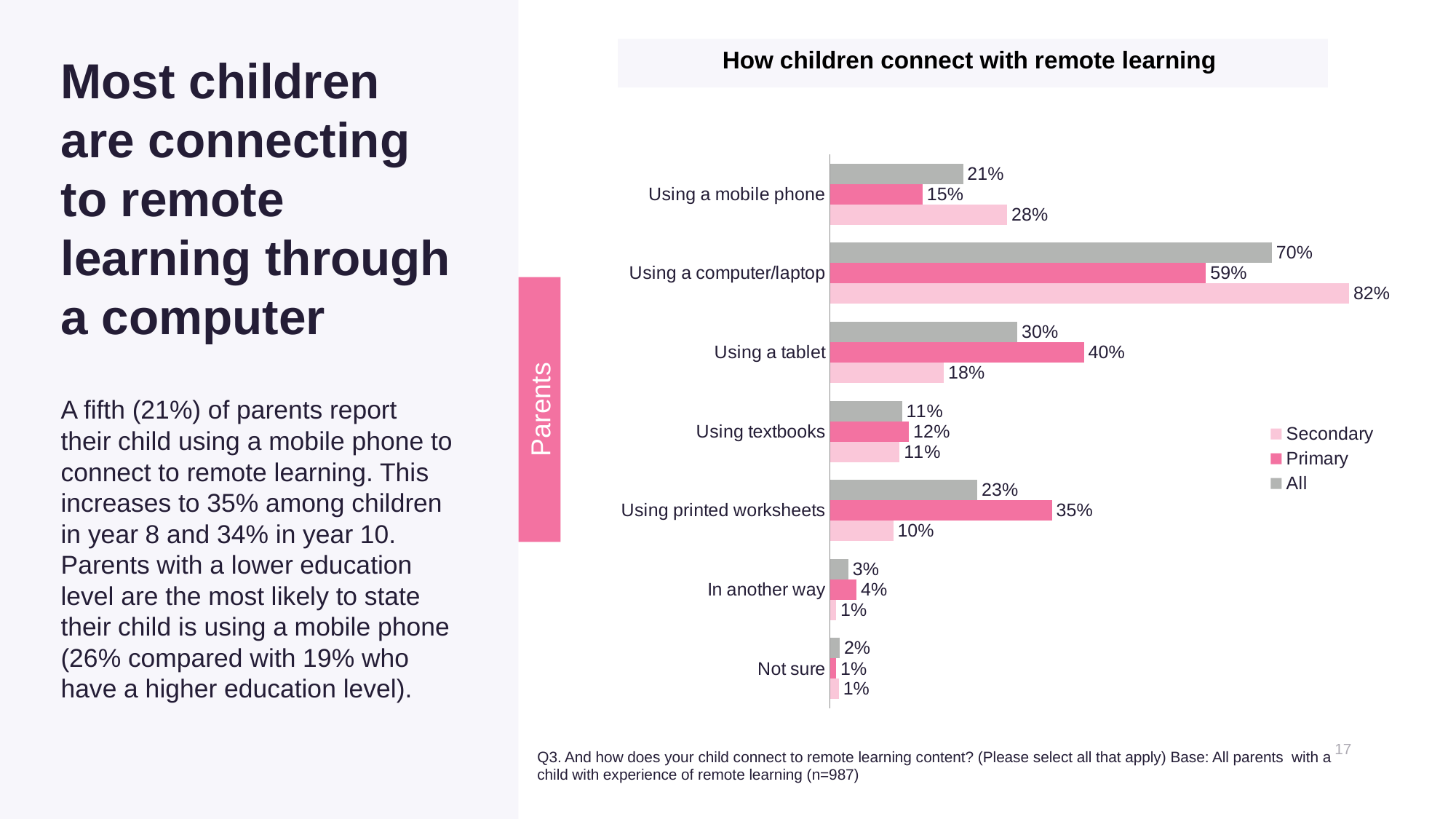
What kind of chart is shown on the slide? Bar chart How many categories are shown on the chart? 7 What is the 'Primary' value for 'Using a tablet'? 40% What is the title of the chart? How children connect with remote learning How many series does the legend list? 3 Which category has the lowest 'All' value? Not sure What is the 'Secondary' value for 'Using a mobile phone'? 28% What is the value for 'All' for 'Using a computer/laptop'? 70% For 'Using printed worksheets', which is larger: the 'Primary' value or the 'Secondary' value? Primary What is the difference between the 'Primary' and 'All' values for 'Using printed worksheets'? 12% Which category has the highest 'Secondary' value? Using a computer/laptop What is the difference between the 'Secondary' and 'Primary' values for 'Using a computer/laptop'? 23%